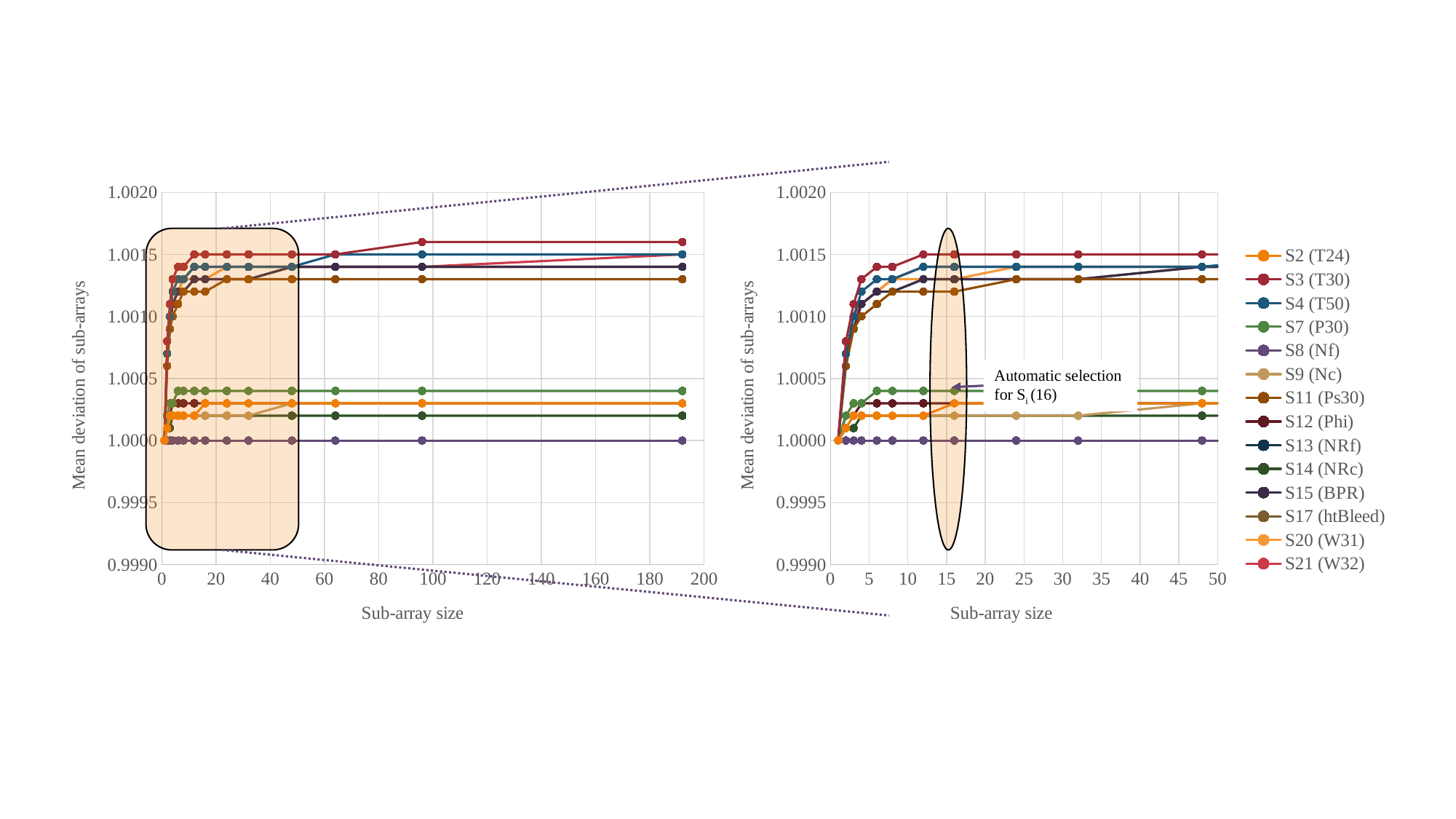
In the right chart, what is the value of S3 (T30) at sub-array size 48? 1.0015 In the right chart, do the values of S3 (T30) rise or fall as sub-array size increases from 1 to 12? rise In the right chart, which series has the lowest value at sub-array size 48? S8 (Nf) What is the x-axis title of the left chart? Sub-array size In the right chart, is the value of S4 (T50) at sub-array size 48 greater or less than 1.0010? greater What kind of chart is the chart on the left of the slide? line chart In the right chart, which is larger at sub-array size 48: S4 (T50) or S2 (T24)? S4 (T50) In the left chart, is the value of S8 (Nf) at sub-array size 192 greater or less than 1.0005? less In the right chart, is the value of S7 (P30) at sub-array size 48 greater or less than 1.0005? less How many series does the legend on the right chart list? 14 What is the y-axis title of the right chart? Mean deviation of sub-arrays In the right chart, what is the value of S8 (Nf) at sub-array size 48? 1.0000